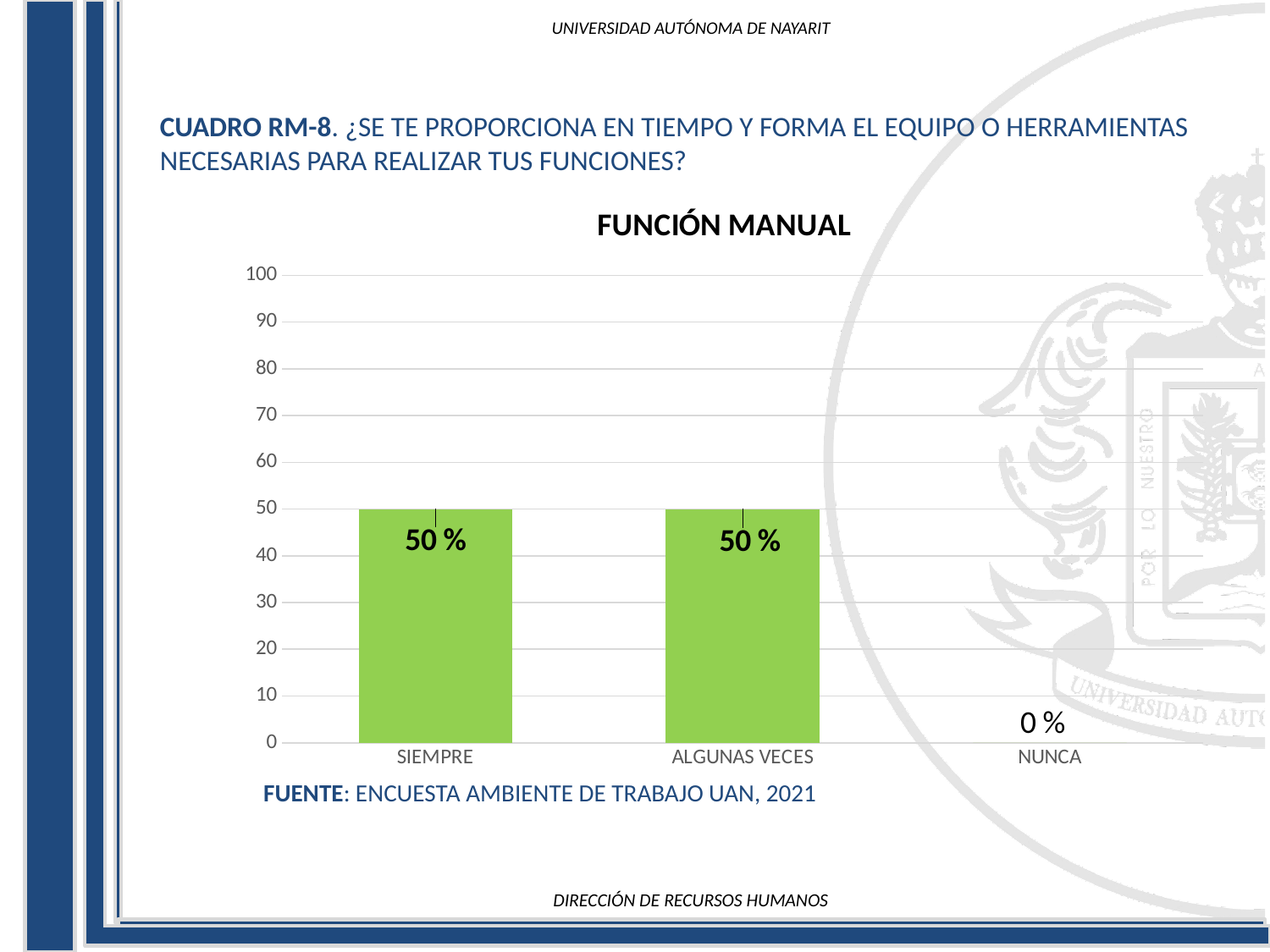
What is the title of the chart? FUNCIÓN MANUAL Which category has the lowest value? NUNCA What is the difference between the values for SIEMPRE and NUNCA? 50 % What is the value for ALGUNAS VECES? 50 % Is the value for SIEMPRE greater or less than 40? greater What colour are the bars in the chart? green What is the value for NUNCA? 0 % What is the value for SIEMPRE? 50 % What is the highest value shown on the y axis? 100 Which is larger, the value for ALGUNAS VECES or the value for NUNCA? ALGUNAS VECES How many categories are shown on the x axis? 3 What kind of chart is shown on the slide? bar chart